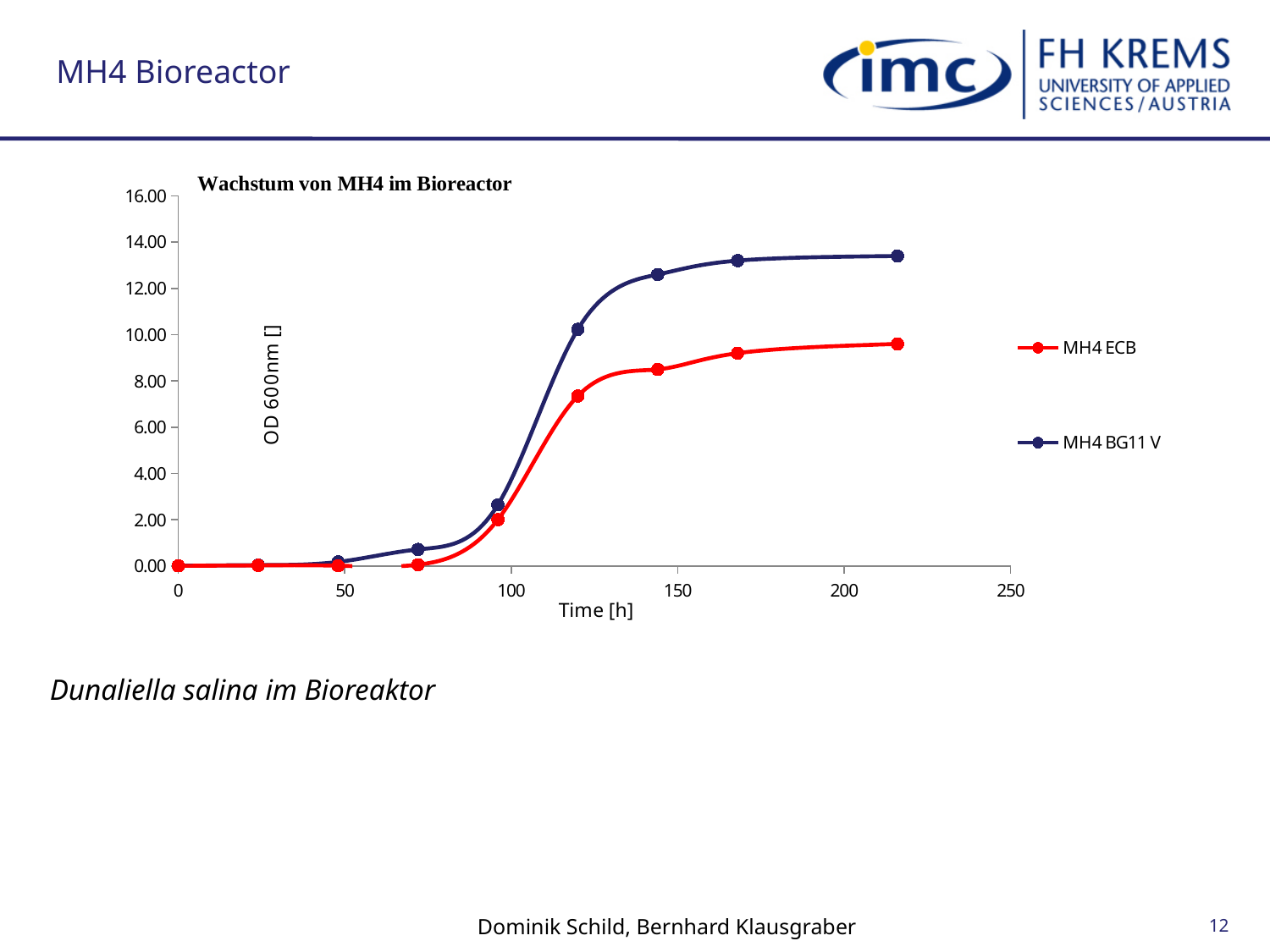
How many data points are plotted for the MH4 BG11 V series? 9 Is the value of MH4 ECB at around 120 h greater or less than 8.00? less Is the final value of MH4 ECB greater or less than 10.00? less What kind of chart is shown on the slide? line chart Which series reaches the higher OD 600nm value at the end of the measurement period? MH4 BG11 V Is the final value of MH4 BG11 V greater or less than 12.00? greater Which series is drawn in red? MH4 ECB What is the label of the x axis? Time [h] What is the title of the chart? Wachstum von MH4 im Bioreactor How many series does the legend list? 2 Do the OD 600nm values for MH4 BG11 V rise or fall as time increases? rise